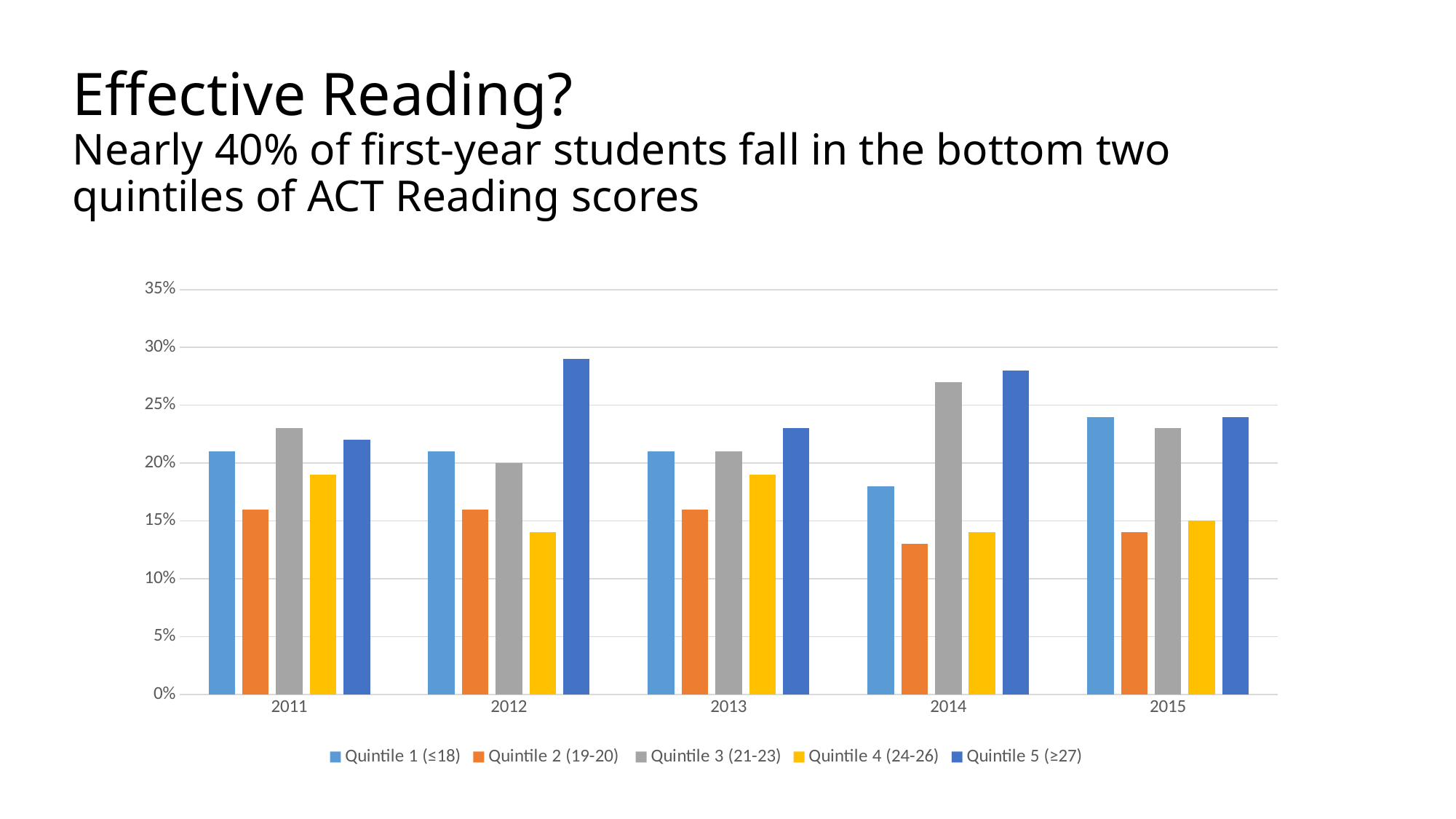
How many series does the chart's legend list? 5 Is the value for Quintile 4 (24-26) in 2012 greater or less than 20%? less In 2014, which is larger: Quintile 3 (21-23) or Quintile 1 (≤18)? Quintile 3 (21-23) Which quintile has the lowest value in 2011? Quintile 2 (19-20) What score range does the legend give for Quintile 5? ≥27 Is the value for Quintile 2 (19-20) in 2014 greater or less than 15%? less Which quintile has the highest value in 2012? Quintile 5 (≥27) How many years are shown on the x axis of the chart? 5 What kind of chart is shown on the slide? bar chart Is the value for Quintile 3 (21-23) in 2014 greater or less than 25%? greater In 2012, which is larger: Quintile 5 (≥27) or Quintile 1 (≤18)? Quintile 5 (≥27)